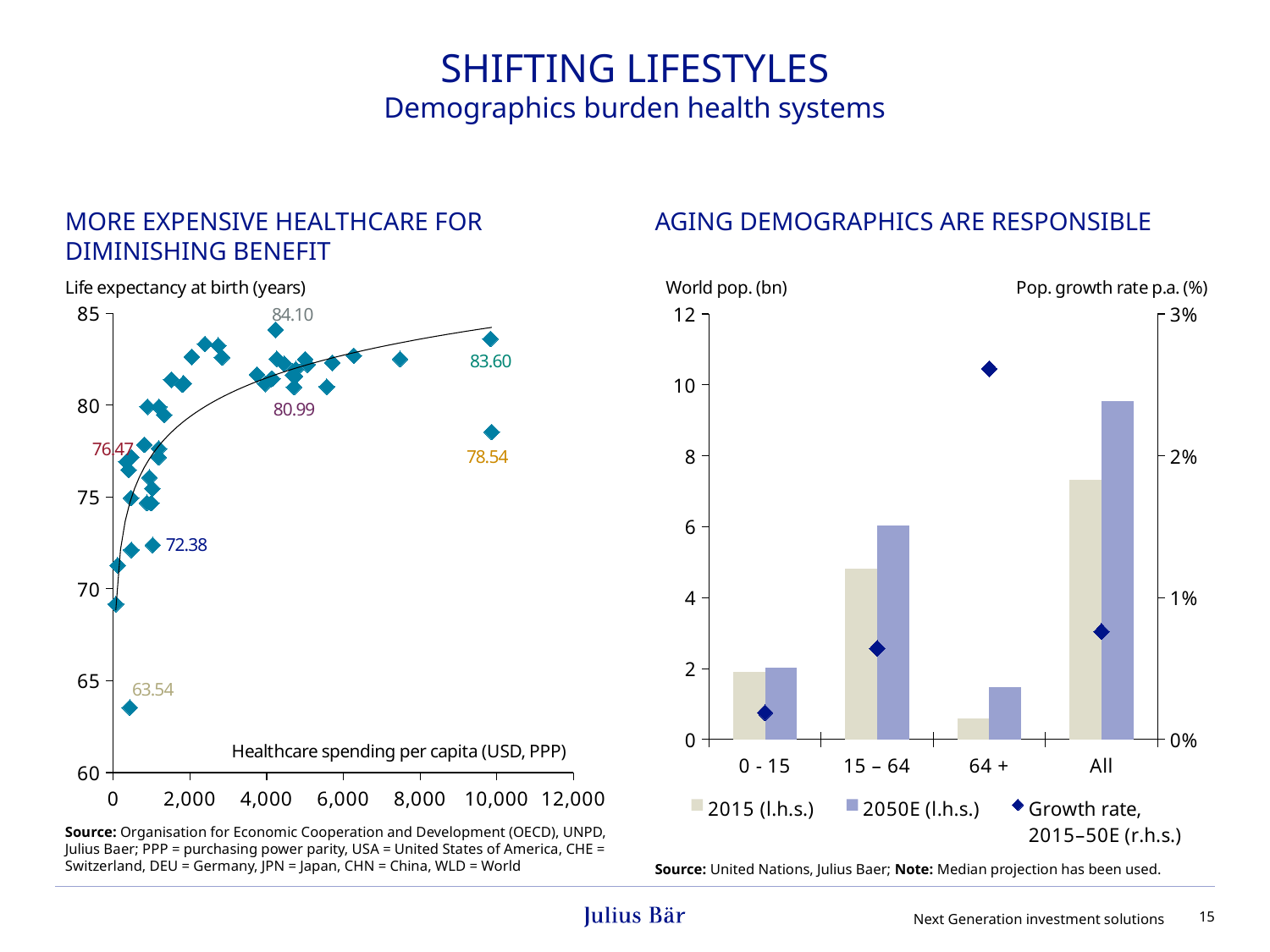
In the right chart, which category has the tallest 2050E bar? All In the left chart, what is the label of the horizontal axis? Healthcare spending per capita (USD, PPP) In the right chart, 'Aging demographics are responsible', how many age categories are shown on the x axis? 4 In the right chart, which category has the shortest 2015 bar? 64 + In the right chart, is the 2050E value for 'All' greater or less than 8? greater In the left chart, what is the difference between the highest labelled value (84.10) and the lowest labelled value (63.54)? 20.56 In the right chart, which category has the highest growth rate marker? 64 + In the right chart, how many series does the legend list? 3 In the left chart, what is the difference between the labelled values 83.60 and 78.54? 5.06 In the left chart, what is the lowest labelled life expectancy value? 63.54 What kind of chart is the left chart, 'More expensive healthcare for diminishing benefit'? scatter chart In the left chart, what is the highest labelled life expectancy value? 84.10